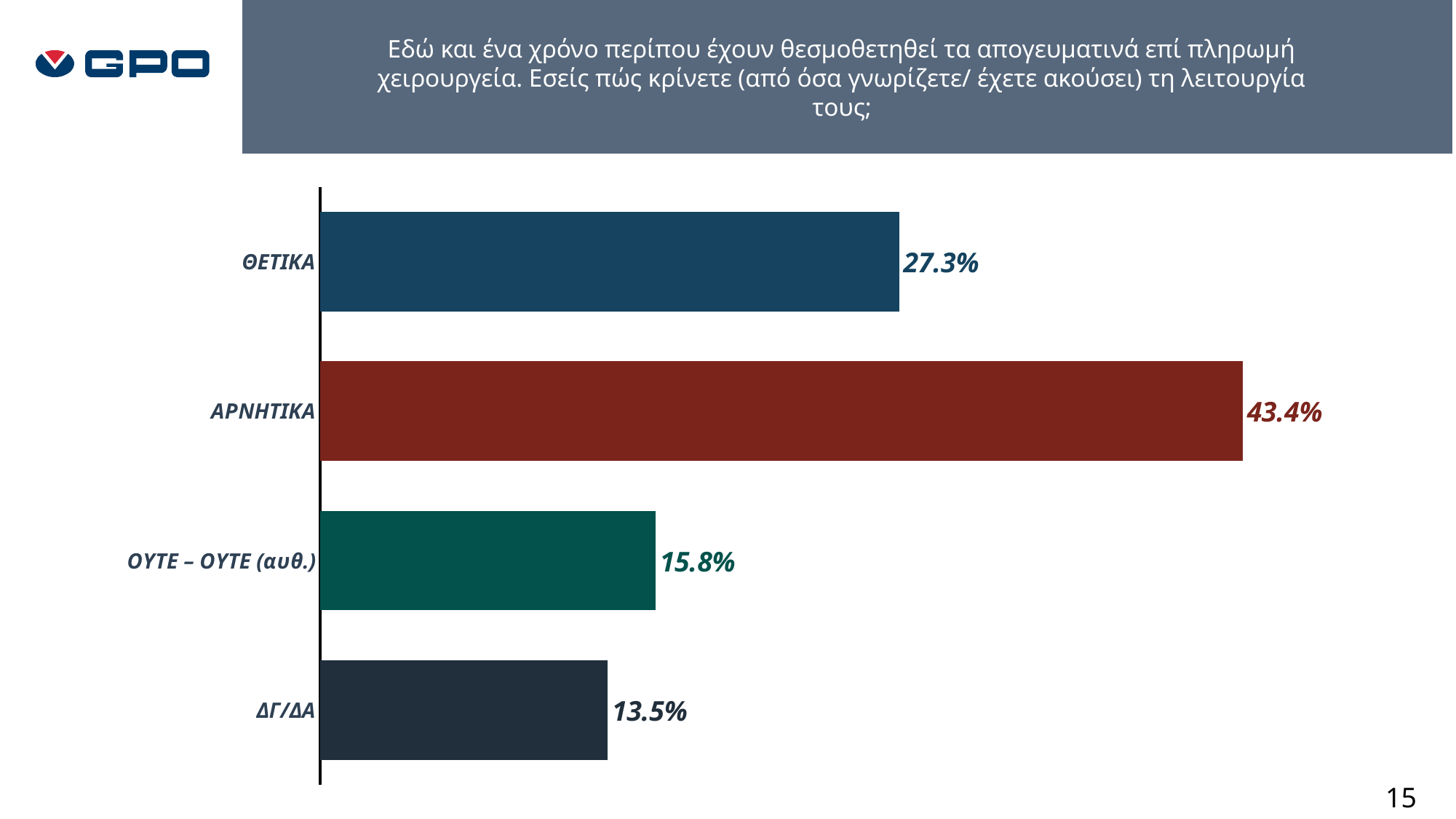
Which is larger, the value for ΘΕΤΙΚΑ or the value for ΑΡΝΗΤΙΚΑ? ΑΡΝΗΤΙΚΑ What is the value for ΘΕΤΙΚΑ? 27.3% What is the value for ΑΡΝΗΤΙΚΑ? 43.4% What is the value for ΟΥΤΕ – ΟΥΤΕ (αυθ.)? 15.8% Which category has the lowest value? ΔΓ/ΔΑ Which category has the highest value? ΑΡΝΗΤΙΚΑ How many categories are shown in the chart? 4 What is the difference between the values for ΟΥΤΕ – ΟΥΤΕ (αυθ.) and ΔΓ/ΔΑ? 2.3% What kind of chart is shown on the slide? Bar chart What is the value for ΔΓ/ΔΑ? 13.5% What is the difference between the values for ΑΡΝΗΤΙΚΑ and ΘΕΤΙΚΑ? 16.1% What colour is the bar for ΑΡΝΗΤΙΚΑ? Dark red